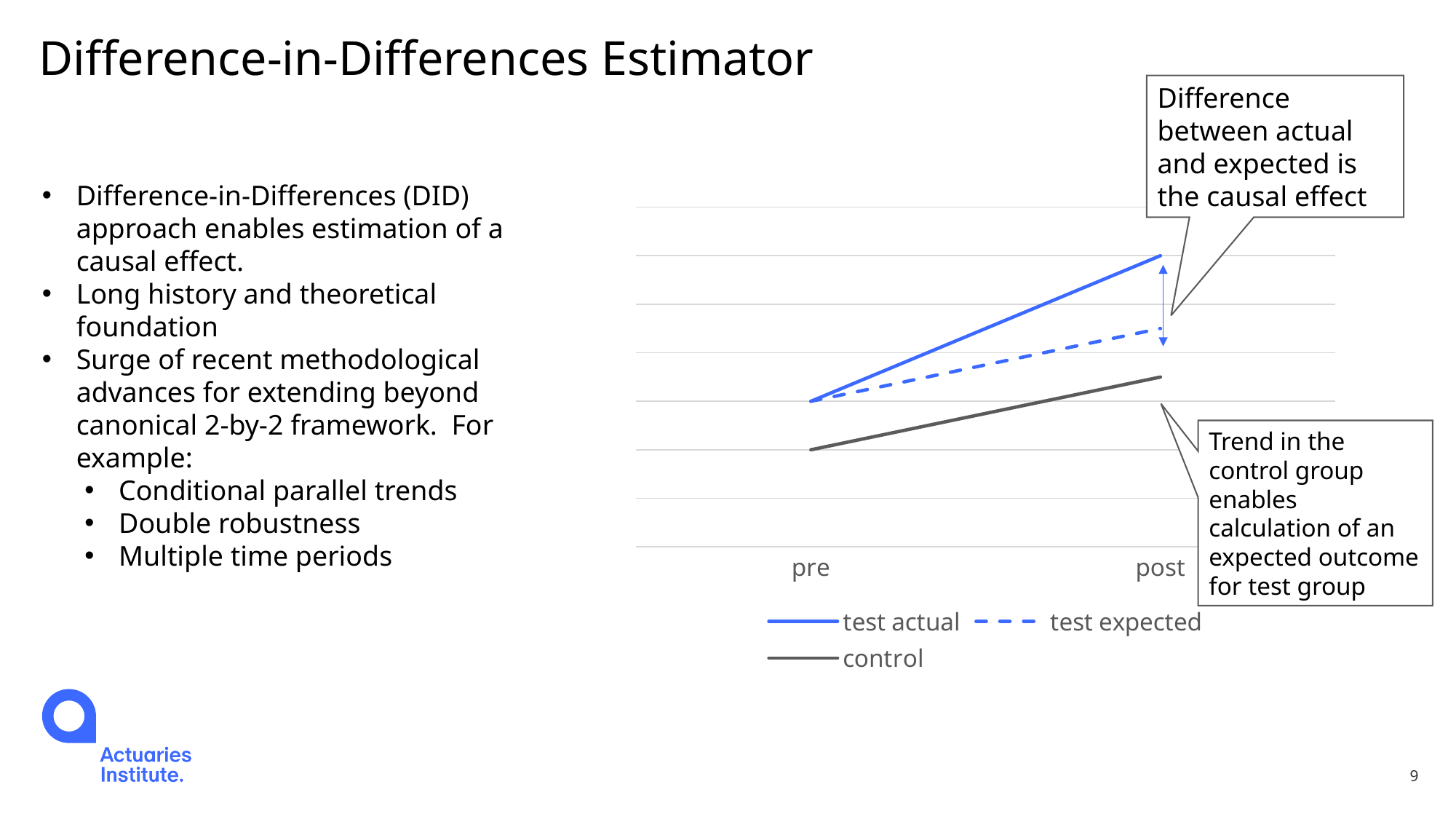
What are the two categories on the x axis of the chart? pre and post How many series does the chart's legend list? 3 Which series has the lowest value at pre? control How many categories are shown on the x axis of the chart? 2 At post, which is larger: the value for 'test actual' or the value for 'test expected'? test actual Does the 'control' series rise or fall from pre to post? rise Which series has the lowest value at post? control What kind of chart is shown on the slide? line chart At pre, which is larger: the value for 'test actual' or the value for 'control'? test actual Which series is plotted with a dashed line in the chart? test expected Which series has the highest value at post? test actual Does the 'test actual' series rise or fall from pre to post? rise